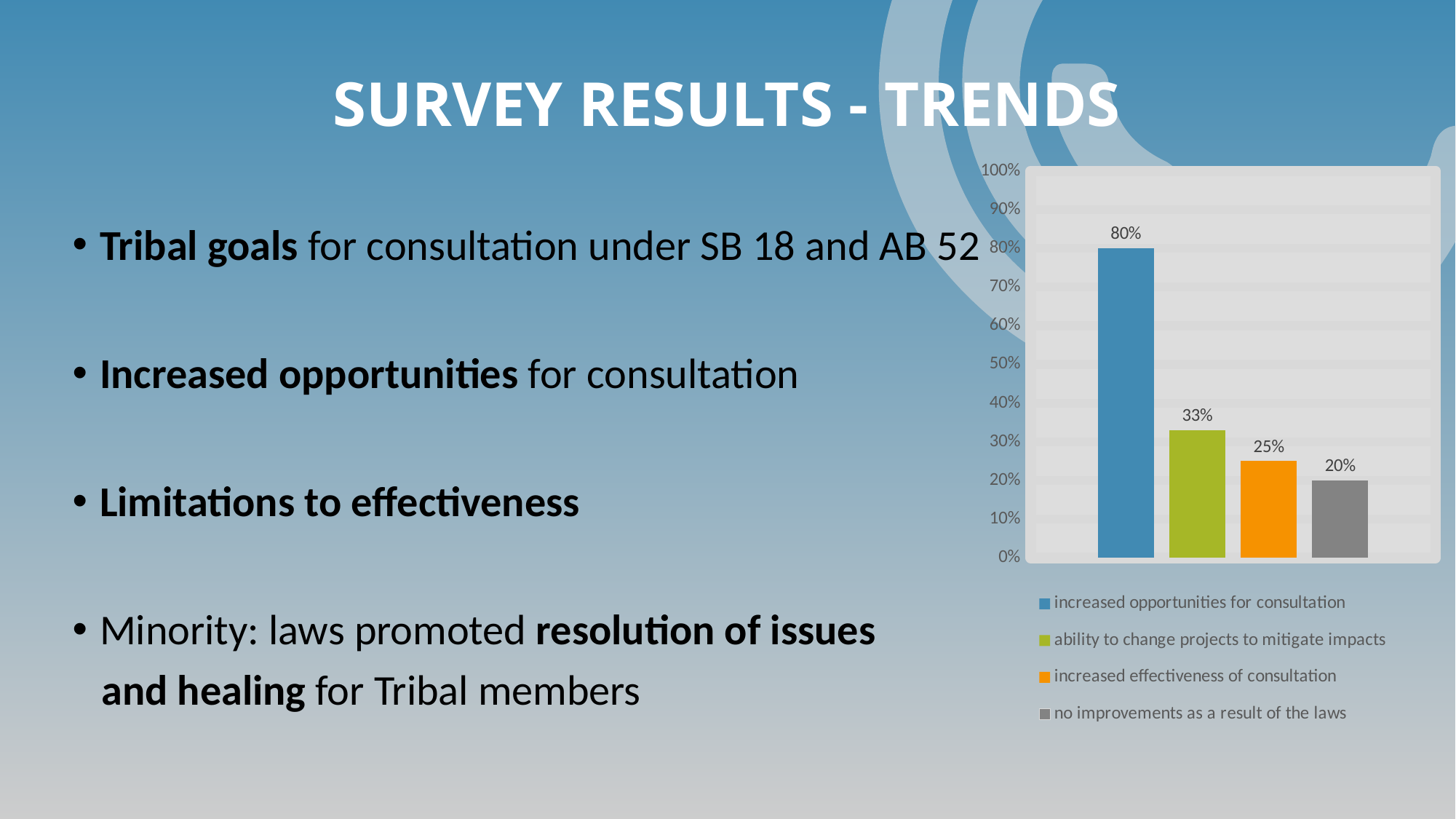
What is the value for 'increased opportunities for consultation'? 80% How many bars are plotted in the chart? 4 What is the value for 'ability to change projects to mitigate impacts'? 33% What is the value for 'increased effectiveness of consultation'? 25% What kind of chart is shown on the slide? bar chart Which is larger: 'ability to change projects to mitigate impacts' or 'increased effectiveness of consultation'? ability to change projects to mitigate impacts What colour is the bar for 'increased effectiveness of consultation'? orange Which category has the lowest value? no improvements as a result of the laws What is the difference between 'increased effectiveness of consultation' and 'no improvements as a result of the laws'? 5% Which category has the highest value? increased opportunities for consultation What is the value for 'no improvements as a result of the laws'? 20% What is the difference between 'increased opportunities for consultation' and 'ability to change projects to mitigate impacts'? 47%